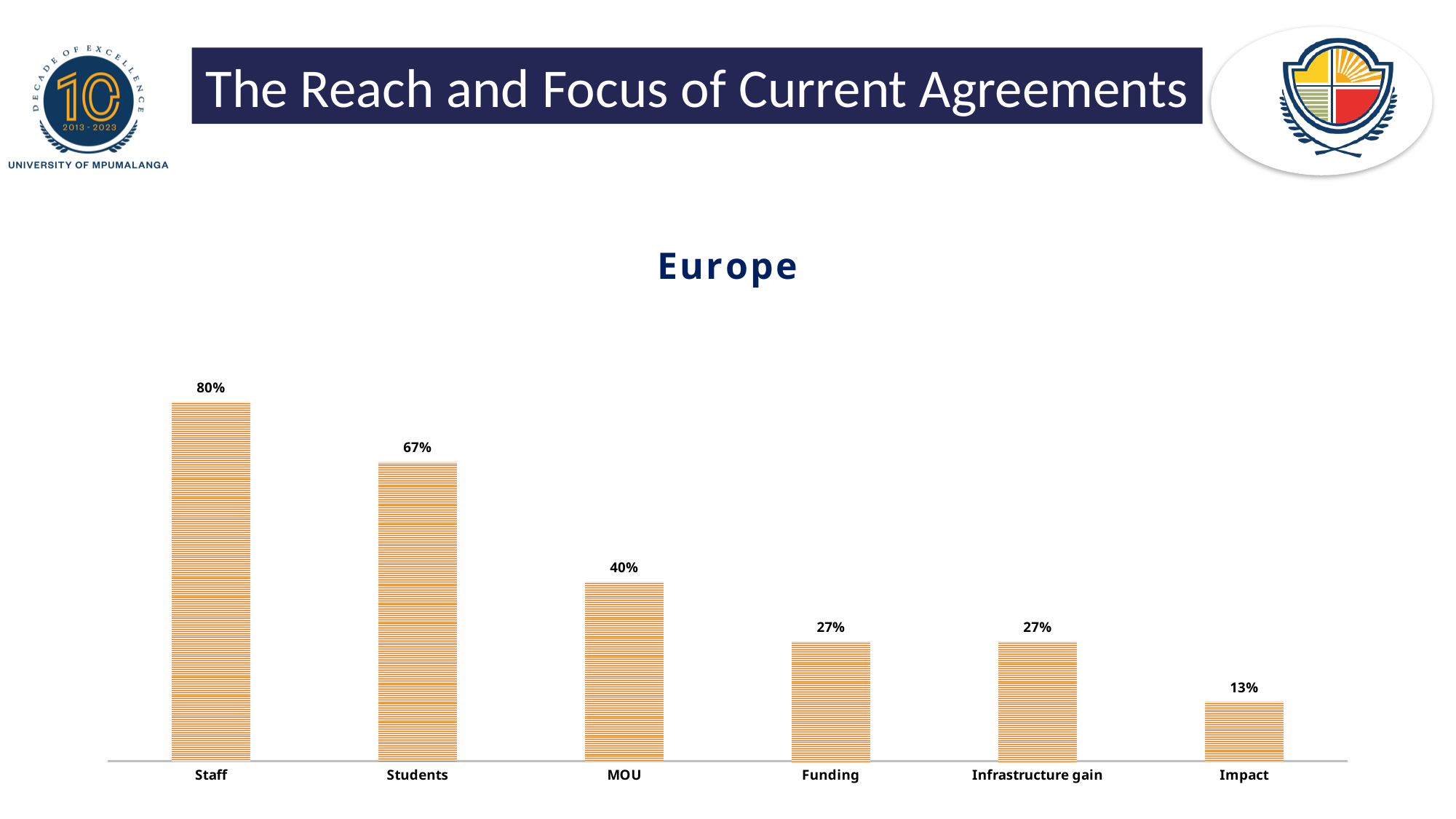
What is the title of the chart? Europe What is the value for Impact? 13% What is the difference between the values for MOU and Impact? 27% What is the value for Students? 67% What is the value for MOU? 40% What is the difference between the values for Staff and Students? 13% Which category has the lowest value? Impact Which is larger, the value for Students or the value for MOU? Students Which category has the highest value? Staff How many categories are shown on the chart? 6 What is the value for Staff? 80% What kind of chart is shown on the slide? Bar chart